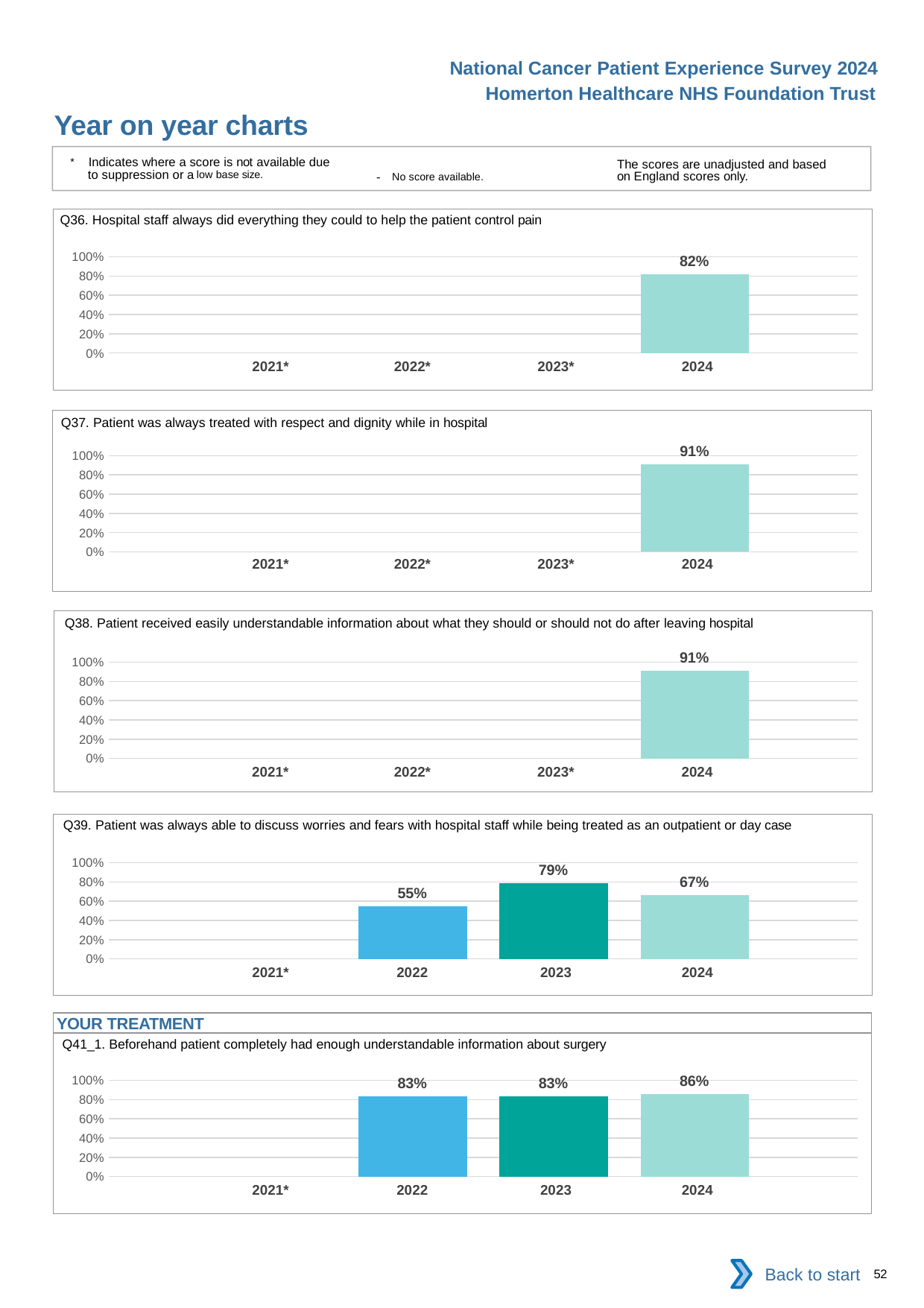
In the Q36 chart, what is the value for 2024? 82% In the Q41_1 chart, what is the difference between the 2024 and 2023 values? 3% In the Q38 chart, what is the value for 2024? 91% What kind of chart is the Q36 chart? bar chart In the Q41_1 chart, what is the value for 2024? 86% In the Q39 chart, what is the value for 2022? 55% In the Q37 chart, what is the value for 2024? 91% In the Q39 chart, is the value for 2024 larger or smaller than the value for 2023? smaller In the Q39 chart, which year has the highest value? 2023 In the Q39 chart, what is the difference between the 2023 and 2022 values? 24% In the Q41_1 chart, how many years have a bar plotted? 3 In the Q36 chart, how many year categories are shown on the x axis? 4